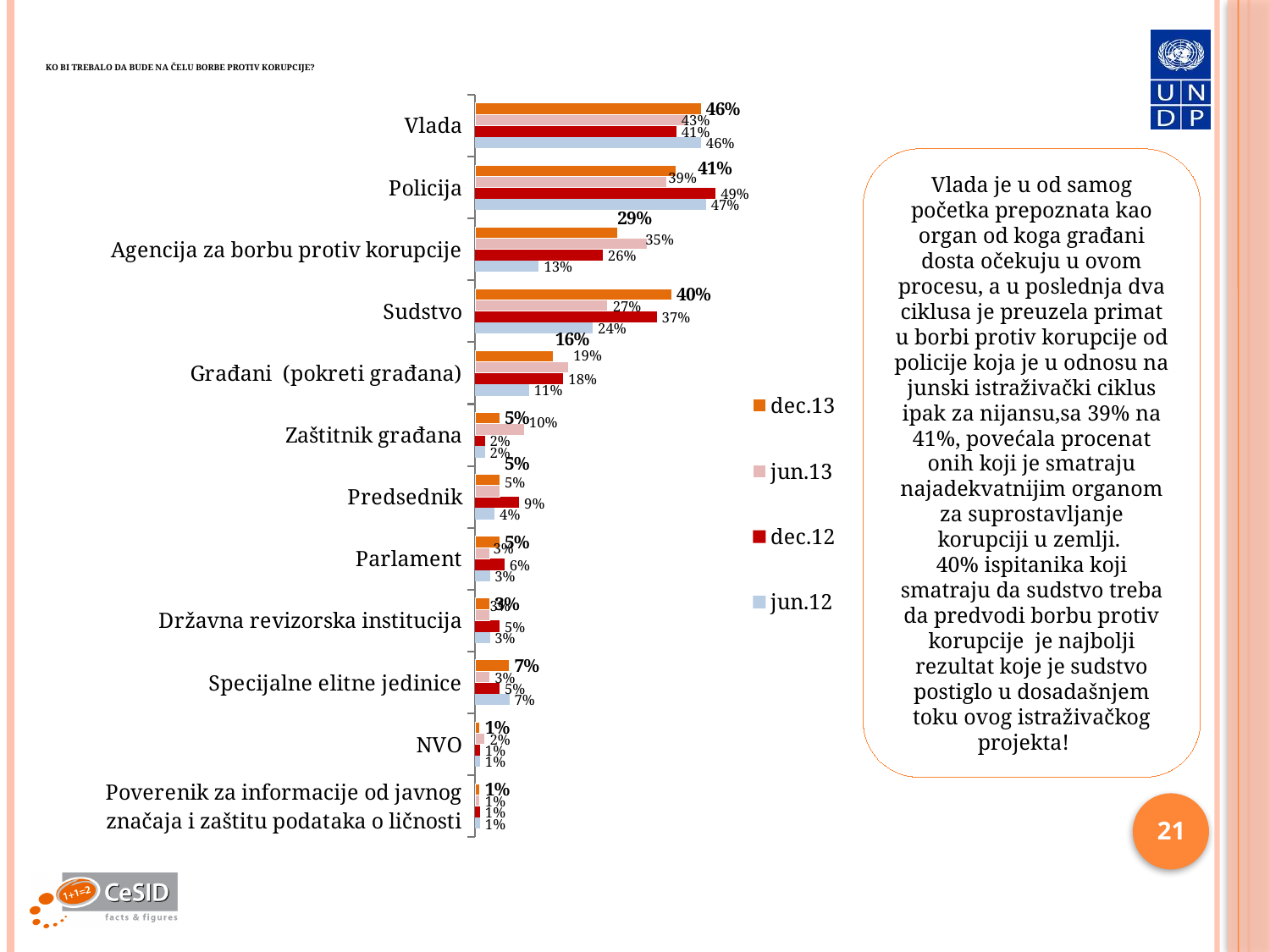
What is the jun.12 value for Agencija za borbu protiv korupcije? 13% What is the difference between the dec.13 and jun.13 values for Sudstvo? 13% Which series is shown in dark red in the legend? dec.12 What is the dec.12 value for Policija? 49% What is the dec.13 value for Vlada? 46% What kind of chart is shown on the slide? bar chart Which category has the highest dec.13 value? Vlada Which category has the highest dec.12 value? Policija What is the jun.13 value for Sudstvo? 27% Which is larger for Agencija za borbu protiv korupcije: the jun.13 value or the dec.13 value? jun.13 How many series does the legend list? 4 How many categories are shown on the chart? 12